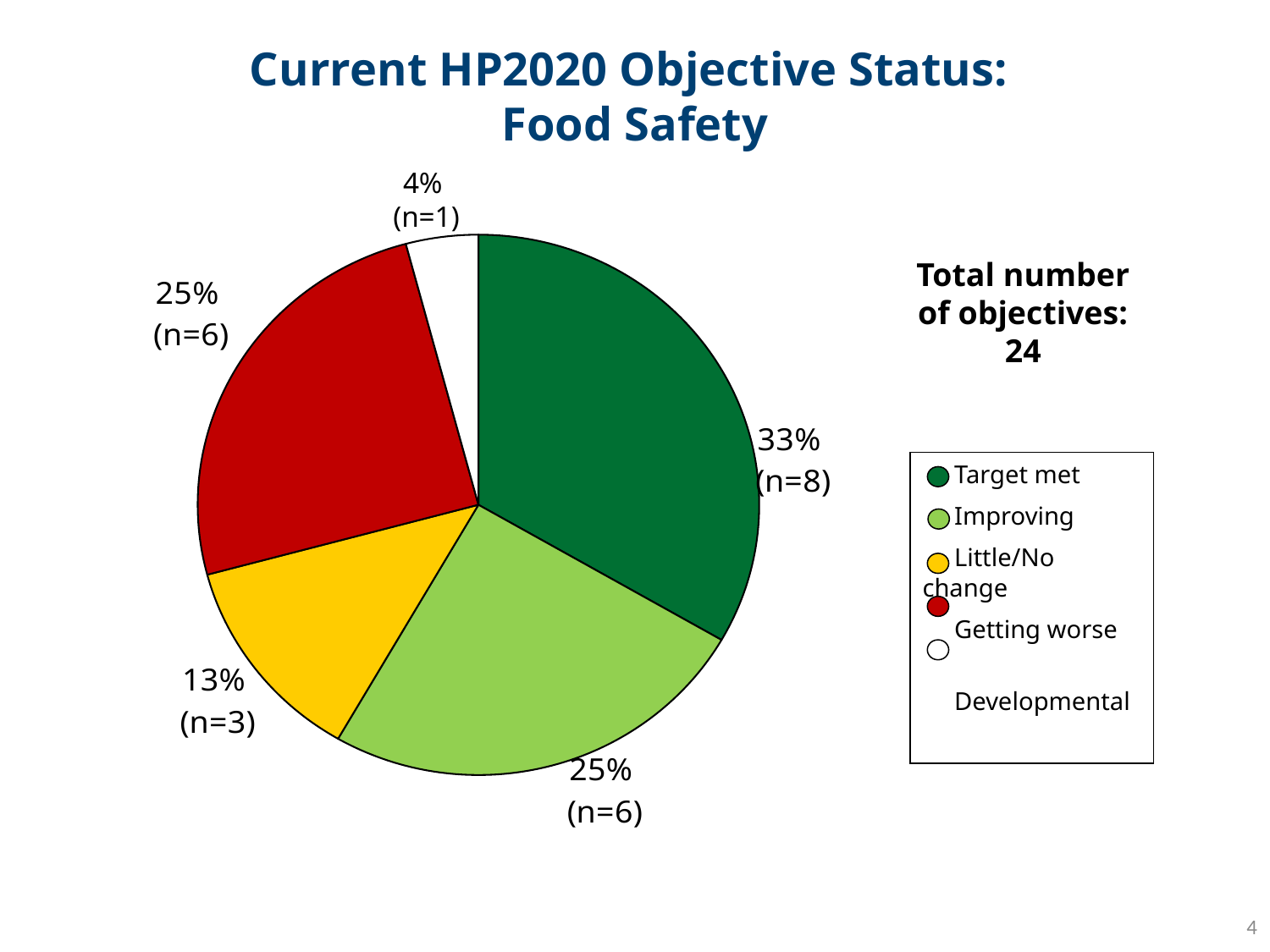
How many objectives are classified as Developmental? 1 What is the total number of objectives shown on the slide? 24 What is the difference in the number of objectives between Target met and Getting worse? 2 What colour represents the Getting worse category in the legend? Red Which category has the largest share of objectives? Target met How many objectives are in the Improving category? 6 What share of the pie is Little/No change? 13% How many categories does the pie chart have? 5 Which category has the smallest share of objectives? Developmental What type of chart is shown on the slide? Pie chart What percentage of Food Safety objectives have met their target? 33% Which has more objectives, Getting worse or Little/No change? Getting worse